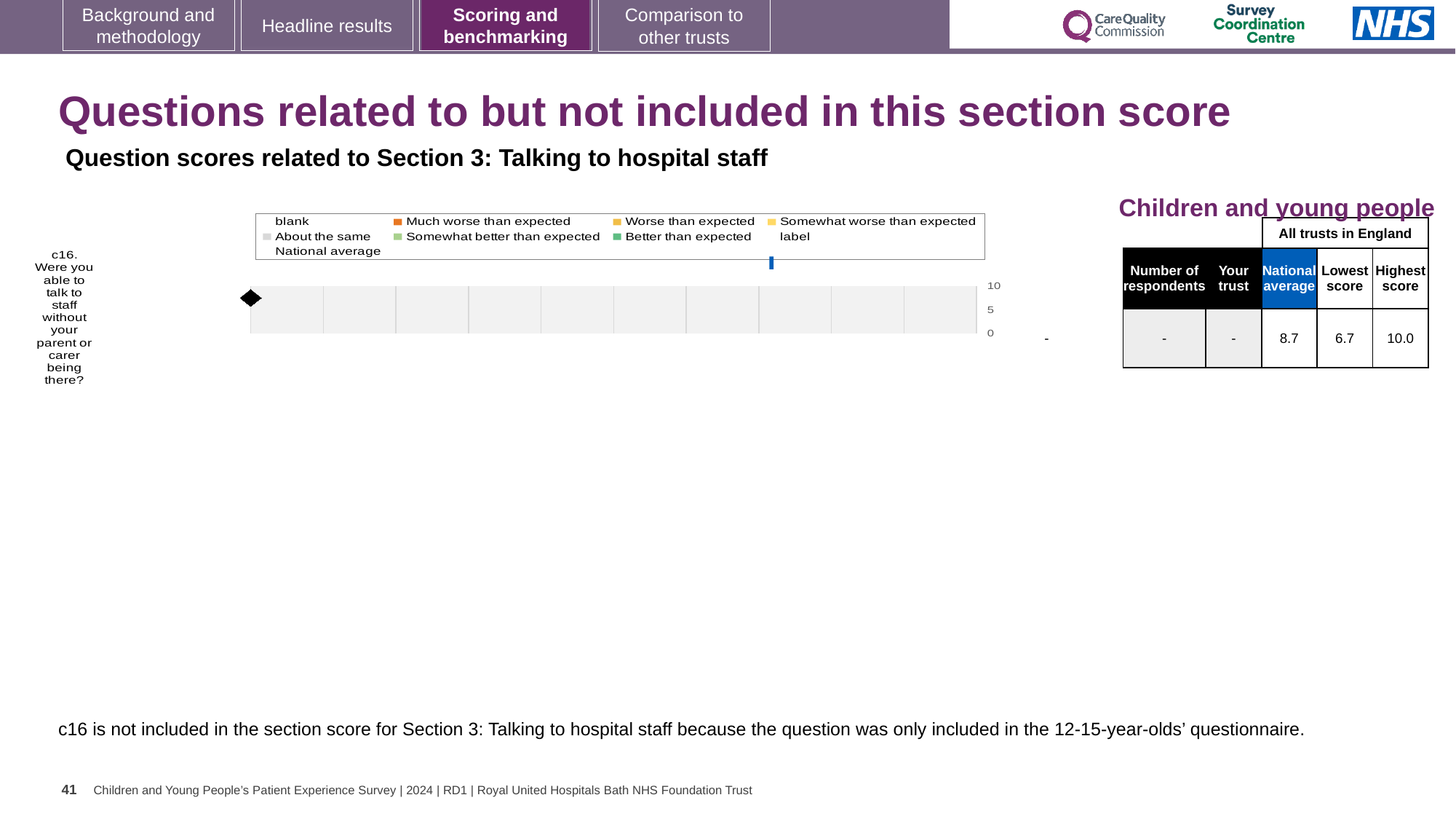
What is the difference between the highest score and the lowest score for c16? 3.3 What is the lowest score across all trusts in England for c16? 6.7 Which is larger for c16, the national average or the lowest score? national average What value is shown for 'Your trust' for c16? - What kind of chart is shown for question c16? bar chart How many questions (categories) are plotted on the chart? 1 Is the national average for c16 greater or less than 5? greater What is the highest score across all trusts in England for c16? 10.0 Which question is plotted on the chart? c16. Were you able to talk to staff without your parent or carer being there? What is the national average score for c16 shown on the slide? 8.7 What is the highest value shown on the chart's axis? 10